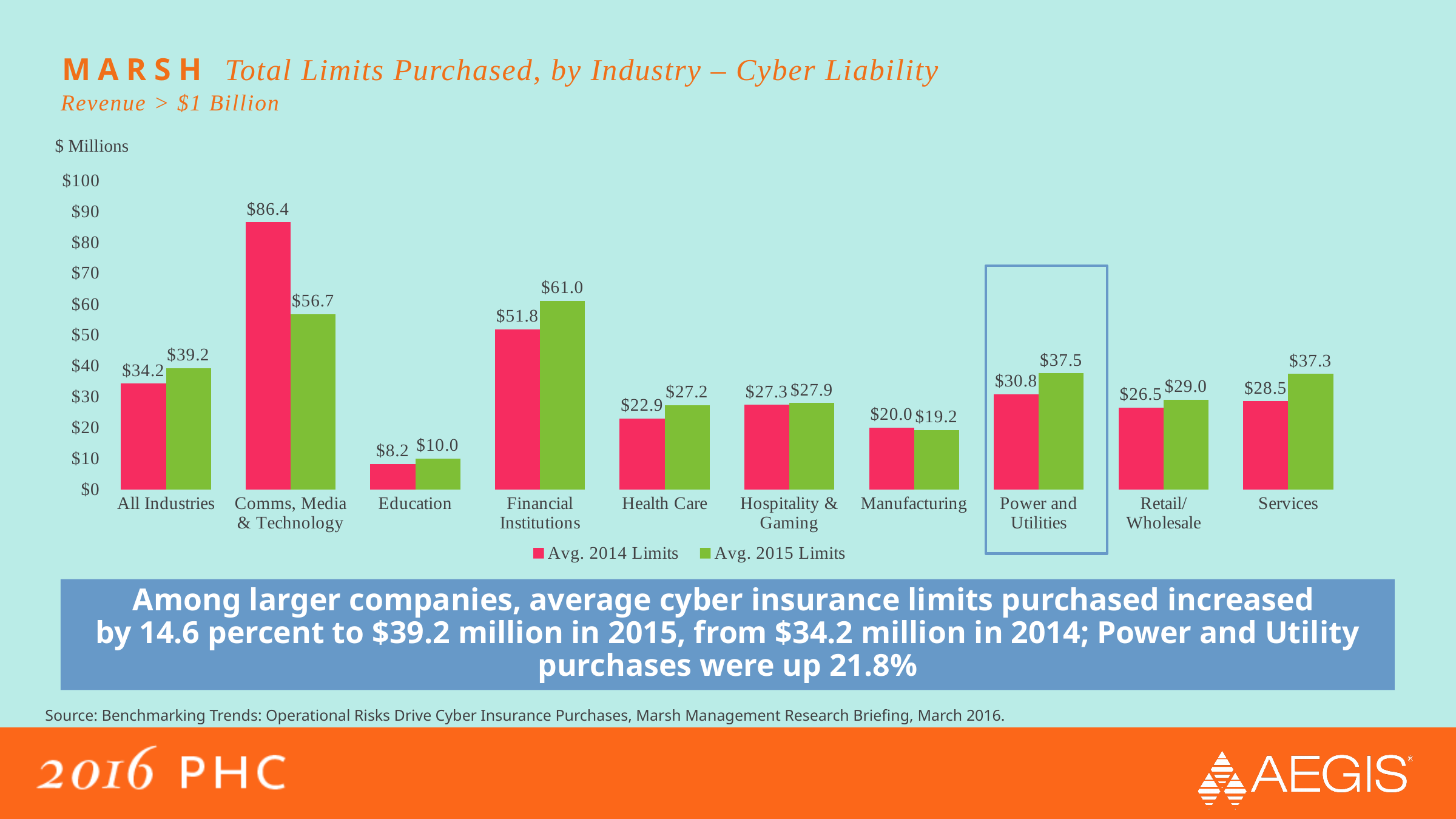
What is the Avg. 2014 Limits value for Power and Utilities? $30.8 Which industry has the lowest Avg. 2015 Limits value? Education Is the Avg. 2015 Limits value for Health Care greater or less than $30? less What is the difference between the Avg. 2015 Limits values for Services and Retail/Wholesale? $8.3 How many series does the legend list? 2 Which is larger for Manufacturing, the Avg. 2014 Limits value or the Avg. 2015 Limits value? Avg. 2014 Limits What kind of chart is shown on the slide? Bar chart How many industry categories are shown on the x axis? 10 What is the Avg. 2015 Limits value for Financial Institutions? $61.0 What is the difference between the Avg. 2014 Limits and Avg. 2015 Limits values for Comms, Media & Technology? $29.7 Which industry has the highest Avg. 2014 Limits value? Comms, Media & Technology What is the Avg. 2015 Limits value for Education? $10.0